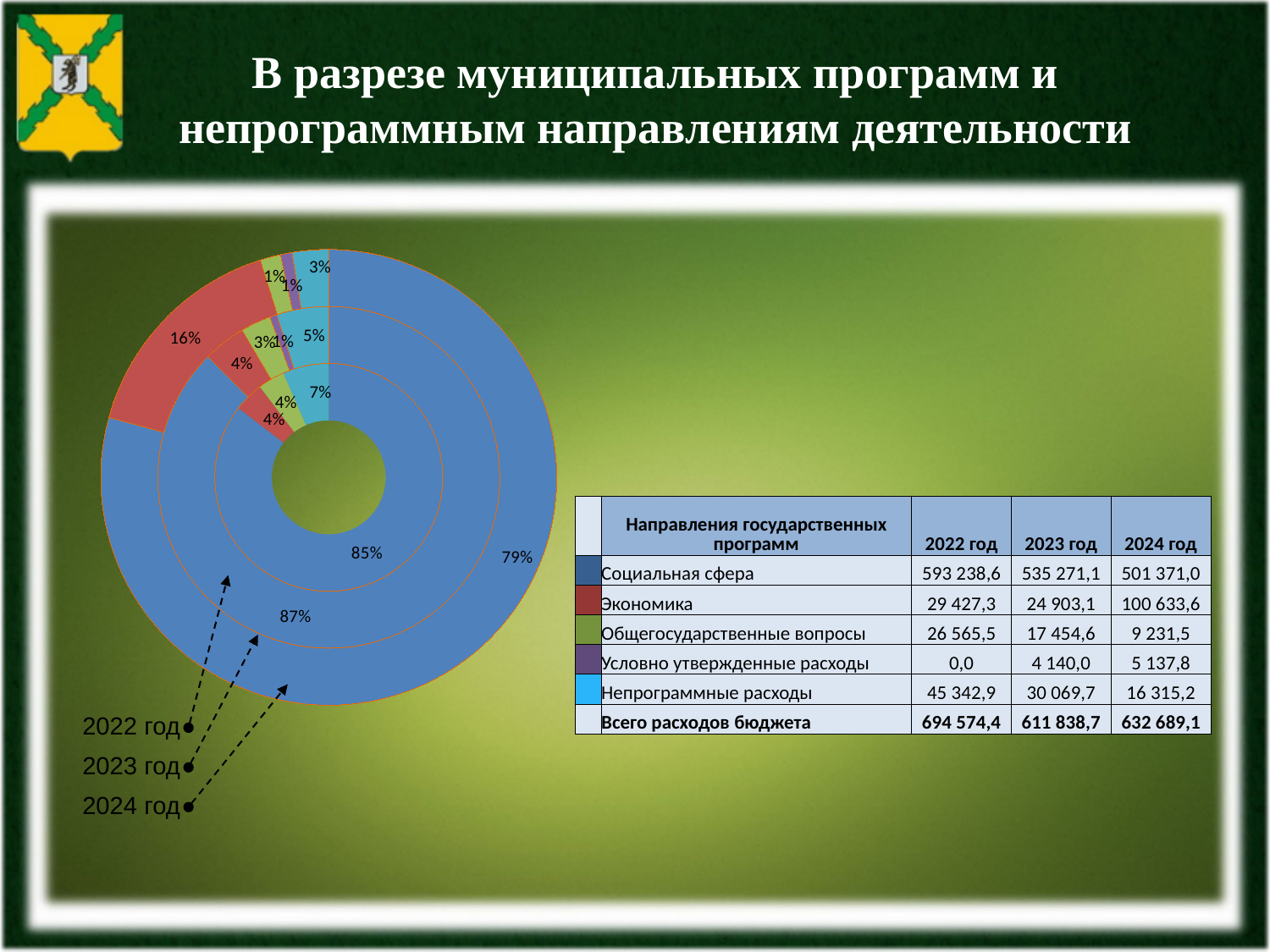
How many rings (years) does the doughnut chart have? 3 What share of the 2022 ring is Непрограммные расходы? 7% Does the share of Непрограммные расходы rise or fall from 2022 to 2024? fall Which category has the largest share in the 2024 ring? Социальная сфера What share of the 2023 ring is Непрограммные расходы? 5% By how many percentage points does the share of Социальная сфера in 2023 exceed its share in 2024? 8 What share of the 2023 ring is Социальная сфера? 87% Is the share of Социальная сфера larger in 2023 or in 2024? 2023 What kind of chart is shown on the slide? doughnut (pie) chart